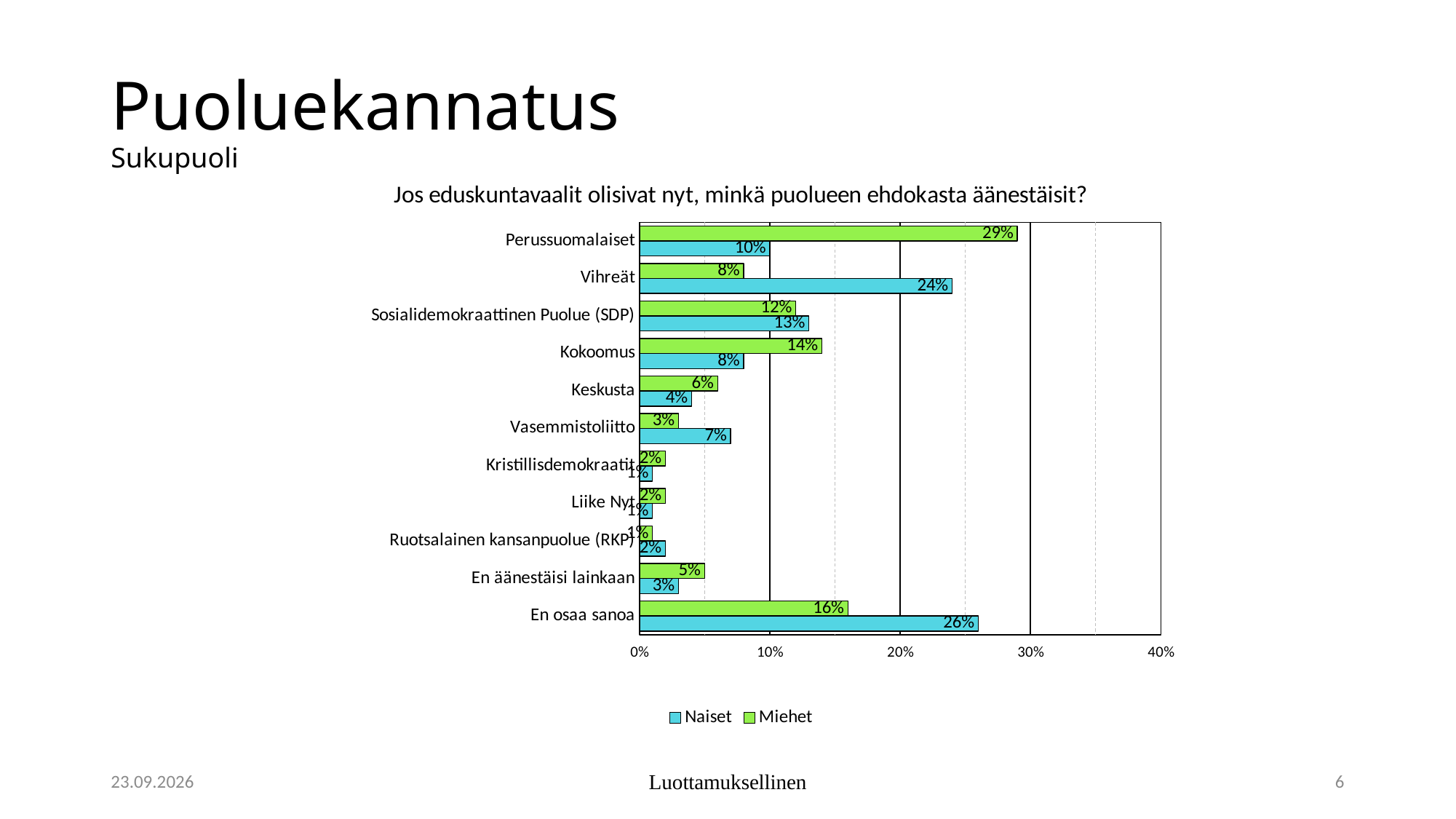
What is the difference between the Naiset and Miehet values for Vihreät? 16% What is the difference between the Miehet and Naiset values for Perussuomalaiset? 19% For Vasemmistoliitto, which is larger: the Naiset value or the Miehet value? Naiset What is the Miehet value for Kokoomus? 14% How many categories are shown on the chart? 11 What percentage of Miehet would vote for Perussuomalaiset? 29% What type of chart is shown on the slide? Bar chart What is the Naiset value for En osaa sanoa? 26% Which category has the highest Miehet value? Perussuomalaiset Which category has the highest Naiset value? En osaa sanoa What percentage of Naiset would vote for Vihreät? 24% How many series does the legend list? 2